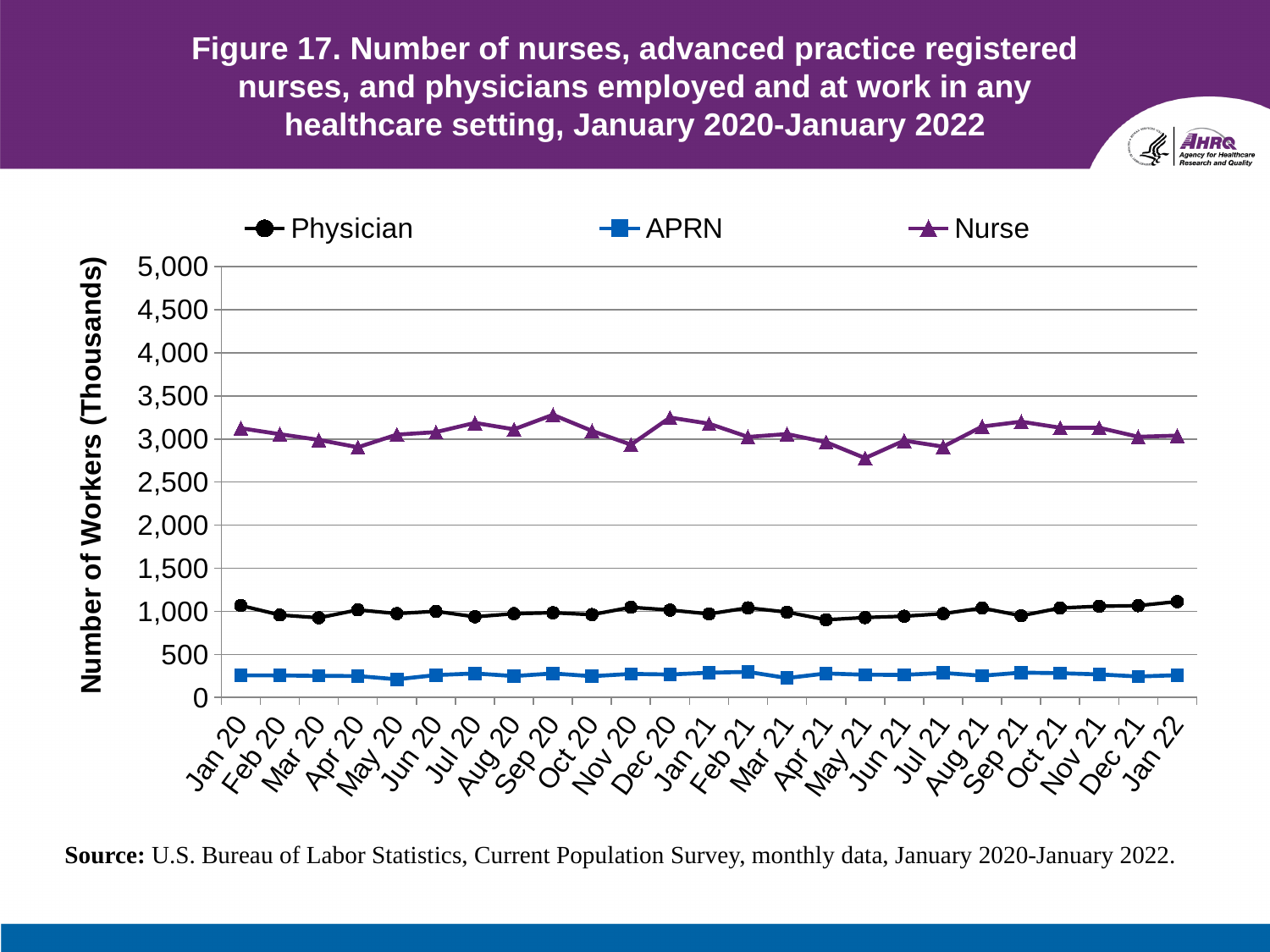
Is the value for Nurse in May 21 greater or less than 3,000? less Is the value for APRN in Jan 20 greater or less than 500? less Is the value for Physician in Jan 22 greater or less than 1,000? greater How many series does the legend list? 3 How many monthly data points are plotted along the x axis for each series? 25 What is the title of the y axis? Number of Workers (Thousands) Which series is plotted with triangle markers? Nurse In Dec 20, which is larger, the value for Nurse or the value for Physician? Nurse Which series has the highest values throughout the chart? Nurse Which series has the lowest values throughout the chart? APRN What kind of chart is shown on the slide? Line chart